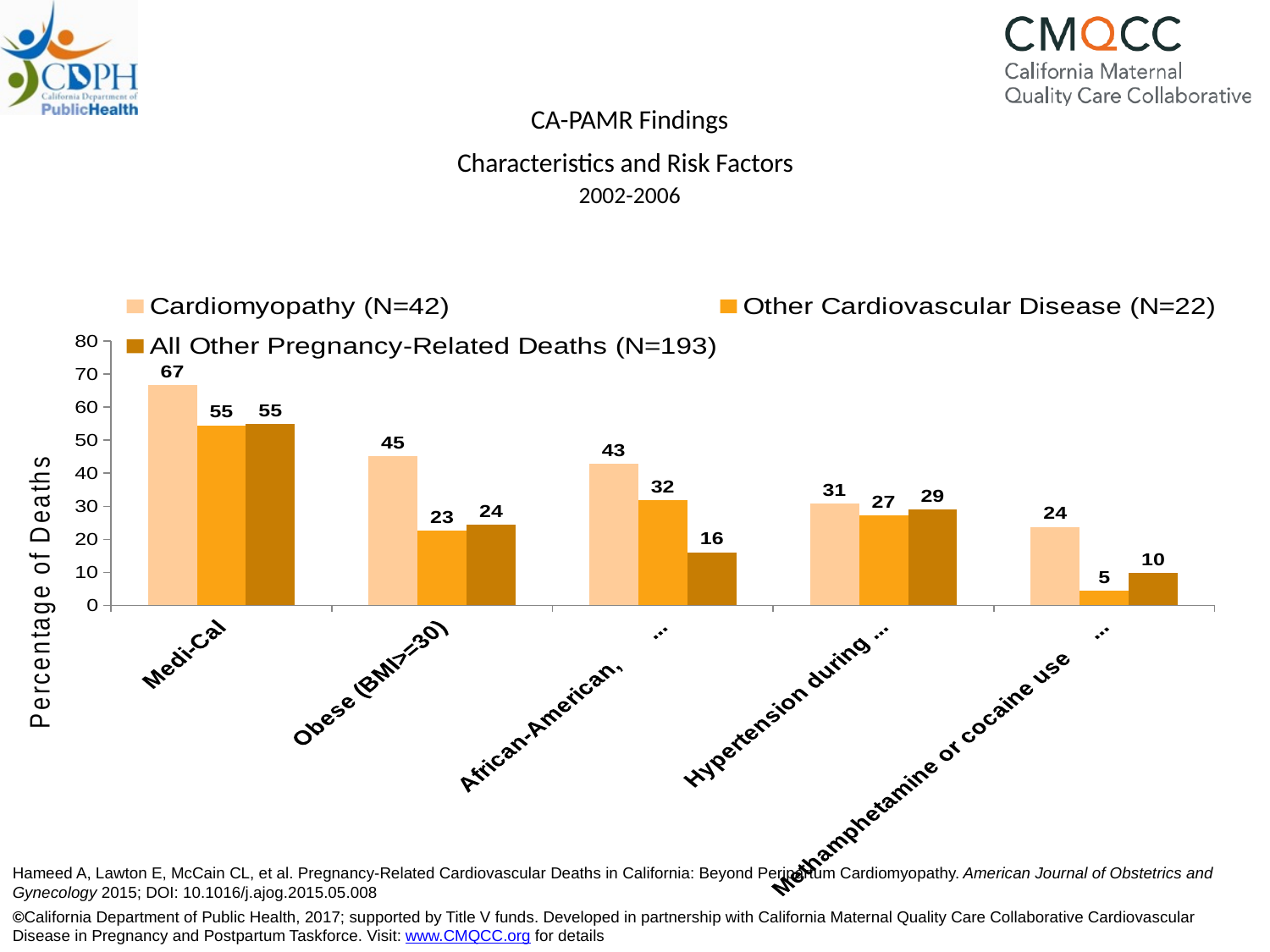
What is the value for All Other Pregnancy-Related Deaths in the Methamphetamine or cocaine use category? 10 What kind of chart is shown on the slide? Bar chart Which category has the lowest value for the Other Cardiovascular Disease series? Methamphetamine or cocaine use Which category has the highest value for the Cardiomyopathy series? Medi-Cal What is the label of the y axis? Percentage of Deaths In the Hypertension during category, which is larger: Other Cardiovascular Disease or All Other Pregnancy-Related Deaths? All Other Pregnancy-Related Deaths What is the value for Other Cardiovascular Disease in the Obese (BMI>=30) category? 23 What percentage of Cardiomyopathy deaths were Medi-Cal? 67 How many series does the legend list? 3 Is the Cardiomyopathy value for Obese (BMI>=30) greater or less than 40? greater How many categories are shown on the x axis? 5 What is the difference between the Cardiomyopathy and All Other Pregnancy-Related Deaths values in the African-American category? 27